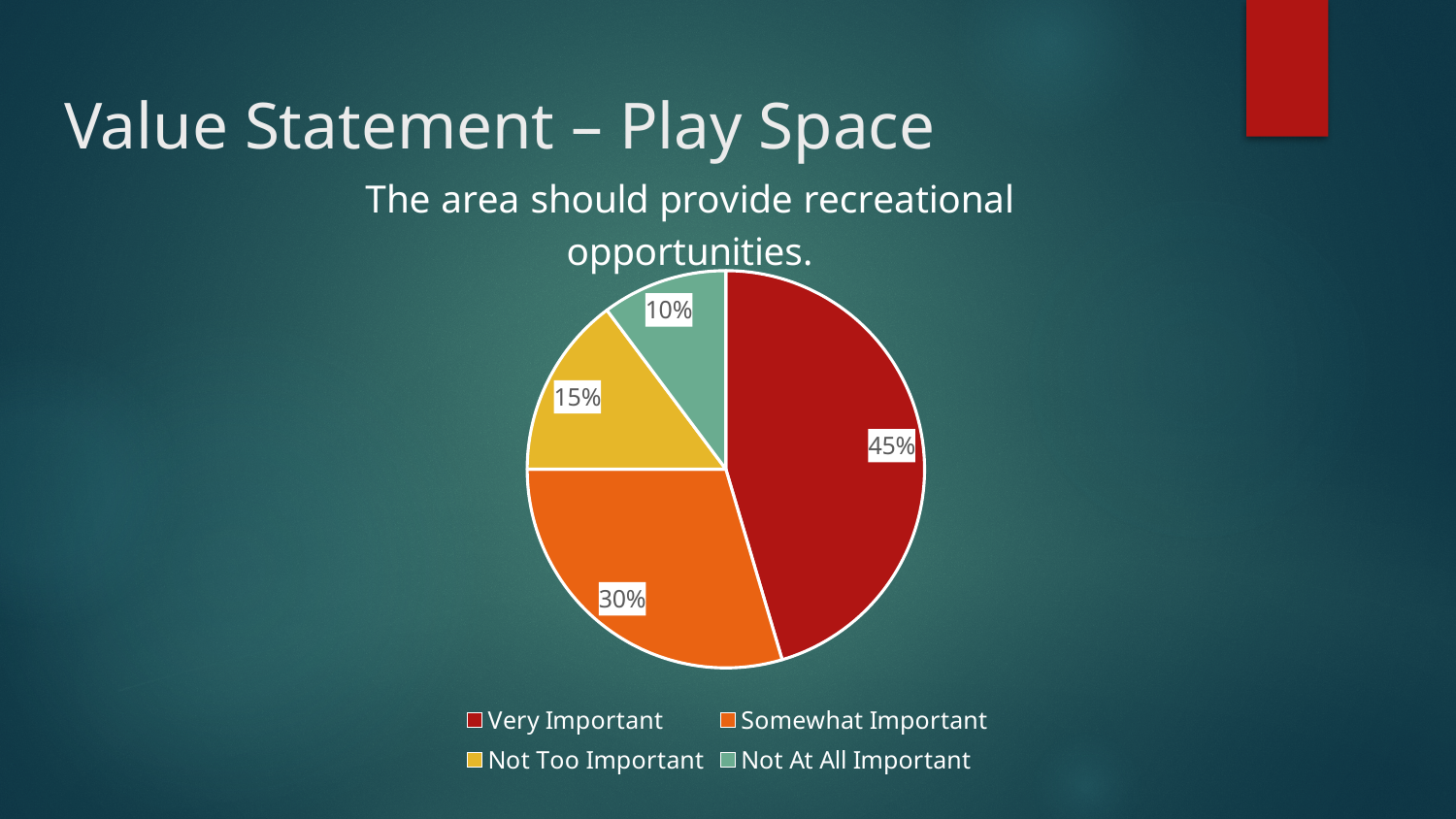
Which category has the smallest slice of the pie? Not At All Important What share of the pie is labelled Not Too Important? 15% What colour is the Somewhat Important slice? Orange Which category has the largest slice of the pie? Very Important How many slices does the pie chart have? 4 What share of the pie is labelled Somewhat Important? 30% What is the title of the chart? The area should provide recreational opportunities. What kind of chart is shown on the slide? Pie chart Which slice is larger, Not Too Important or Not At All Important? Not Too Important What is the difference in percentage points between the Very Important and Somewhat Important slices? 15 What share of the pie is labelled Not At All Important? 10%